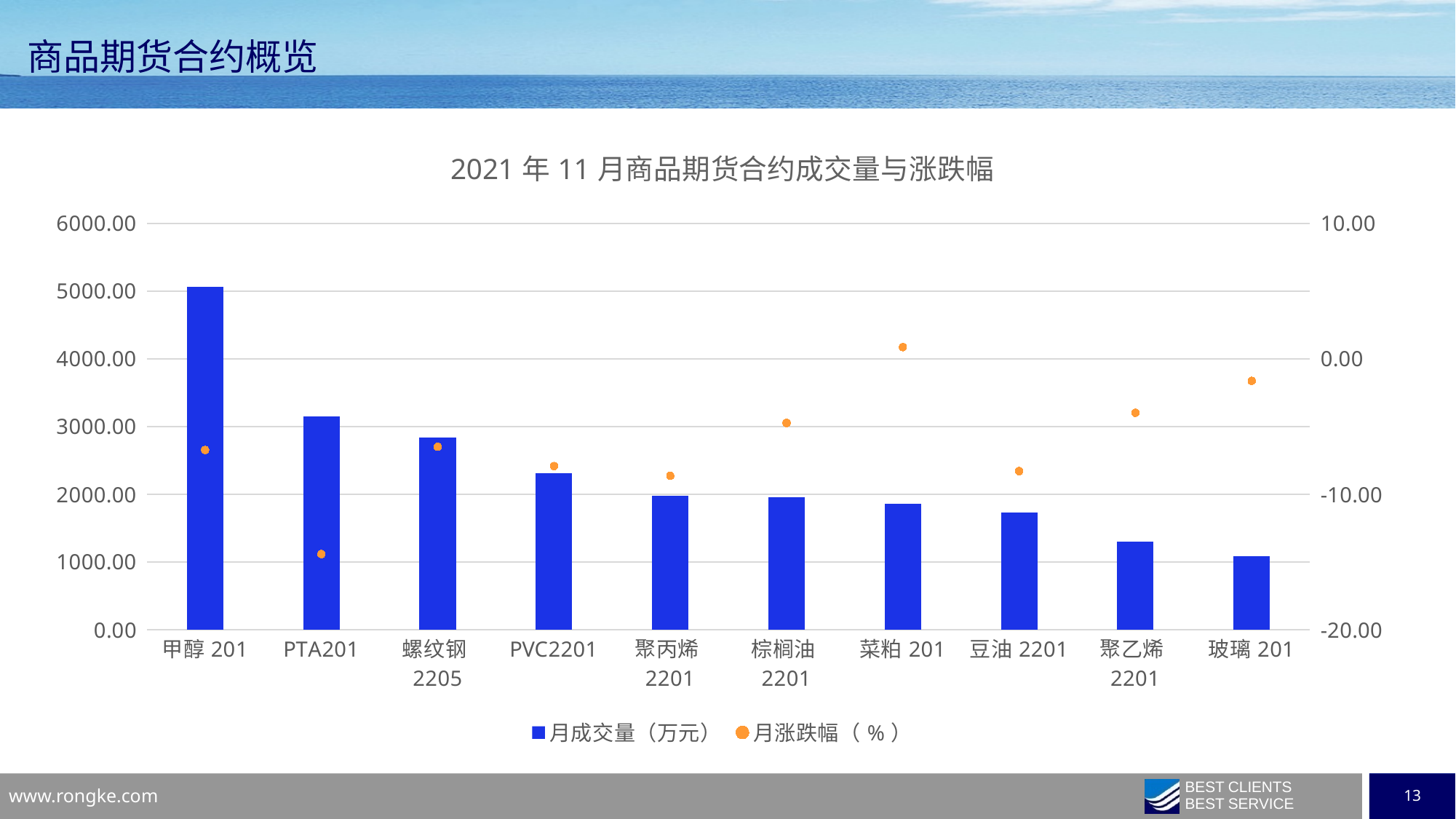
Which contract has the highest 月成交量（万元）? 甲醇 201 How many contract categories are shown on the x axis? 10 What is the title of the chart? 2021 年 11 月商品期货合约成交量与涨跌幅 Do the 月成交量（万元） bars rise or fall from left to right along the x axis? fall How many series does the legend list? 2 Which contract has the highest 月涨跌幅（%）? 菜粕 201 What kind of chart is shown on the slide? A bar chart combined with a dot (scatter) series Which contract has the lowest 月成交量（万元）? 玻璃 201 Which has the larger 月成交量（万元）, 螺纹钢 2205 or PVC2201? 螺纹钢 2205 Which contract has the lowest 月涨跌幅（%）? PTA201 Is the 月成交量（万元） for 甲醇 201 greater or less than 4000? greater Is the 月成交量（万元） for 玻璃 201 greater or less than 2000? less